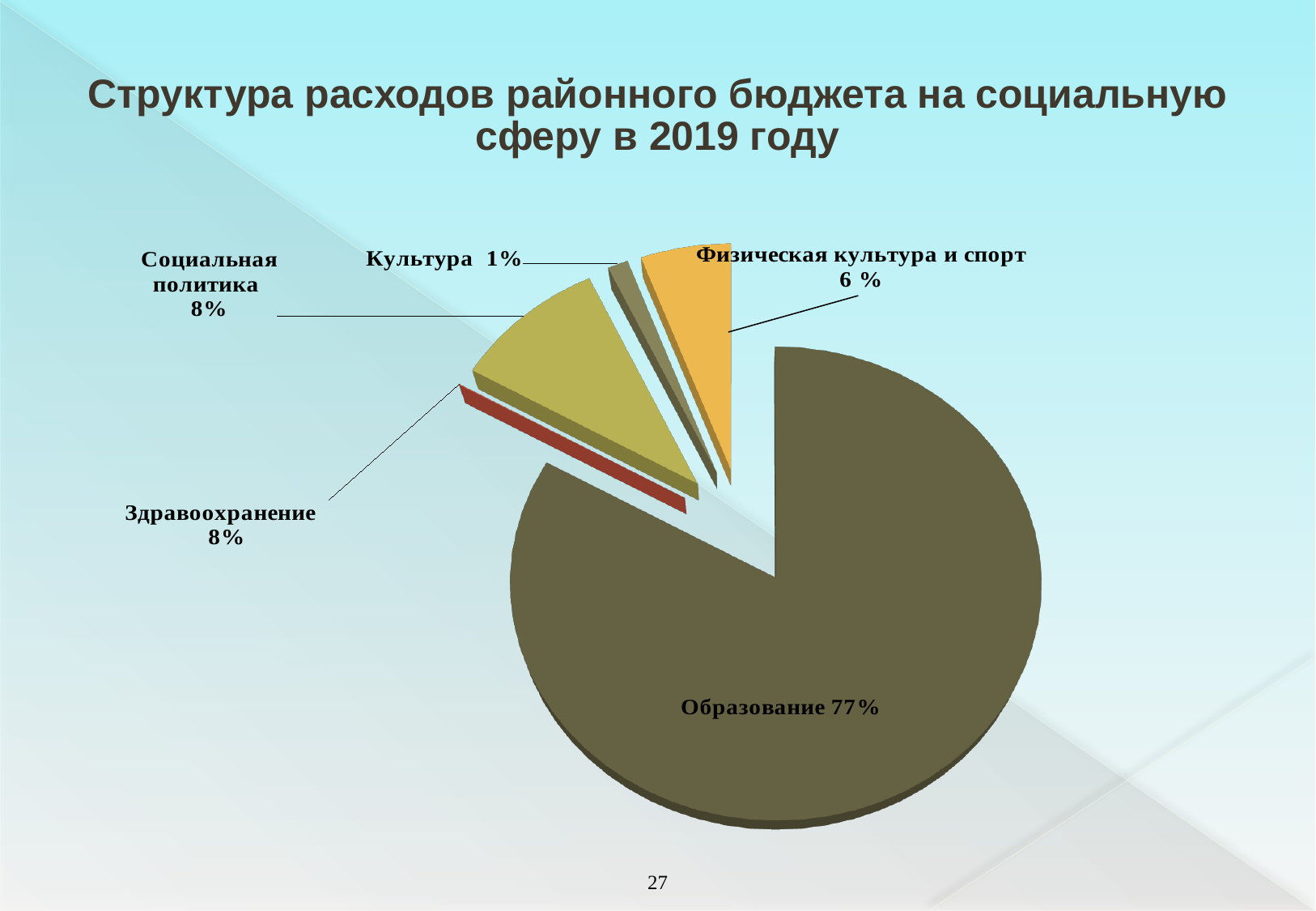
How many categories are shown in the pie chart? 5 What percentage is shown for Социальная политика? 8% What share of the pie does Образование account for? 77% Which category has the largest share of the pie? Образование What percentage is shown for Культура? 1% What percentage is shown for Физическая культура и спорт? 6 % Which category has the smallest share of the pie? Культура Which is larger, the share for Физическая культура и спорт or the share for Культура? Физическая культура и спорт What percentage is shown for Здравоохранение? 8% What kind of chart is shown on the slide? Pie chart By how many percentage points does Образование exceed Здравоохранение? 69 Which is larger, the share for Образование or the share for Социальная политика? Образование